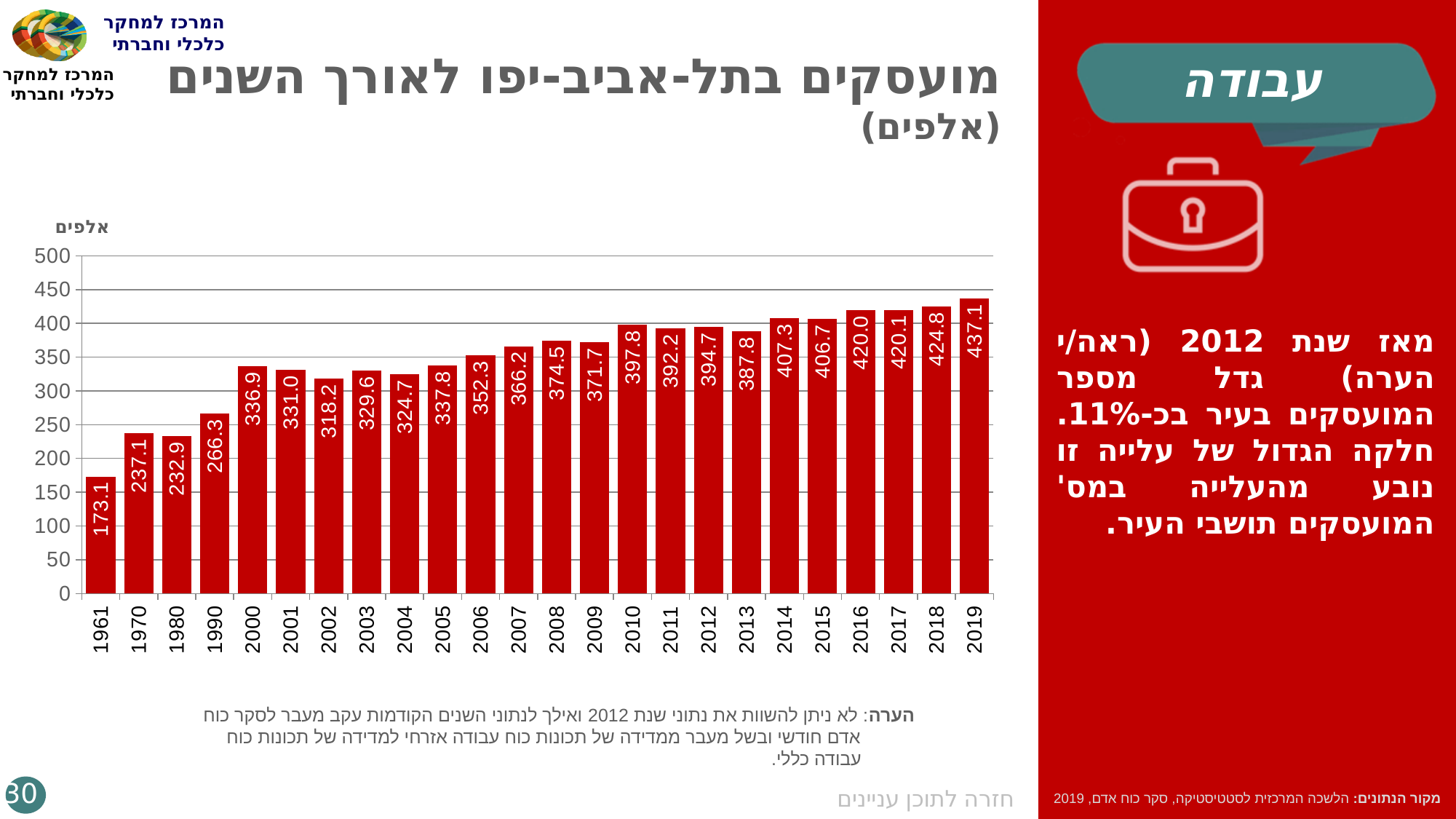
Which is larger, the value for 1970 or the value for 1980? 1970 What is the difference between the values for 2019 and 2012? 42.4 Which year has the lowest value? 1961 What type of chart is shown on the slide? bar chart What is the value for 2012? 394.7 What is the difference between the values for 2018 and 2017? 4.7 How many years are shown on the x axis? 24 What is the value for 2019? 437.1 What is the value for 1961? 173.1 Which year has the highest value? 2019 Is the value for 2010 greater or less than 350? greater Do the values generally rise or fall from 1961 to 2019? rise